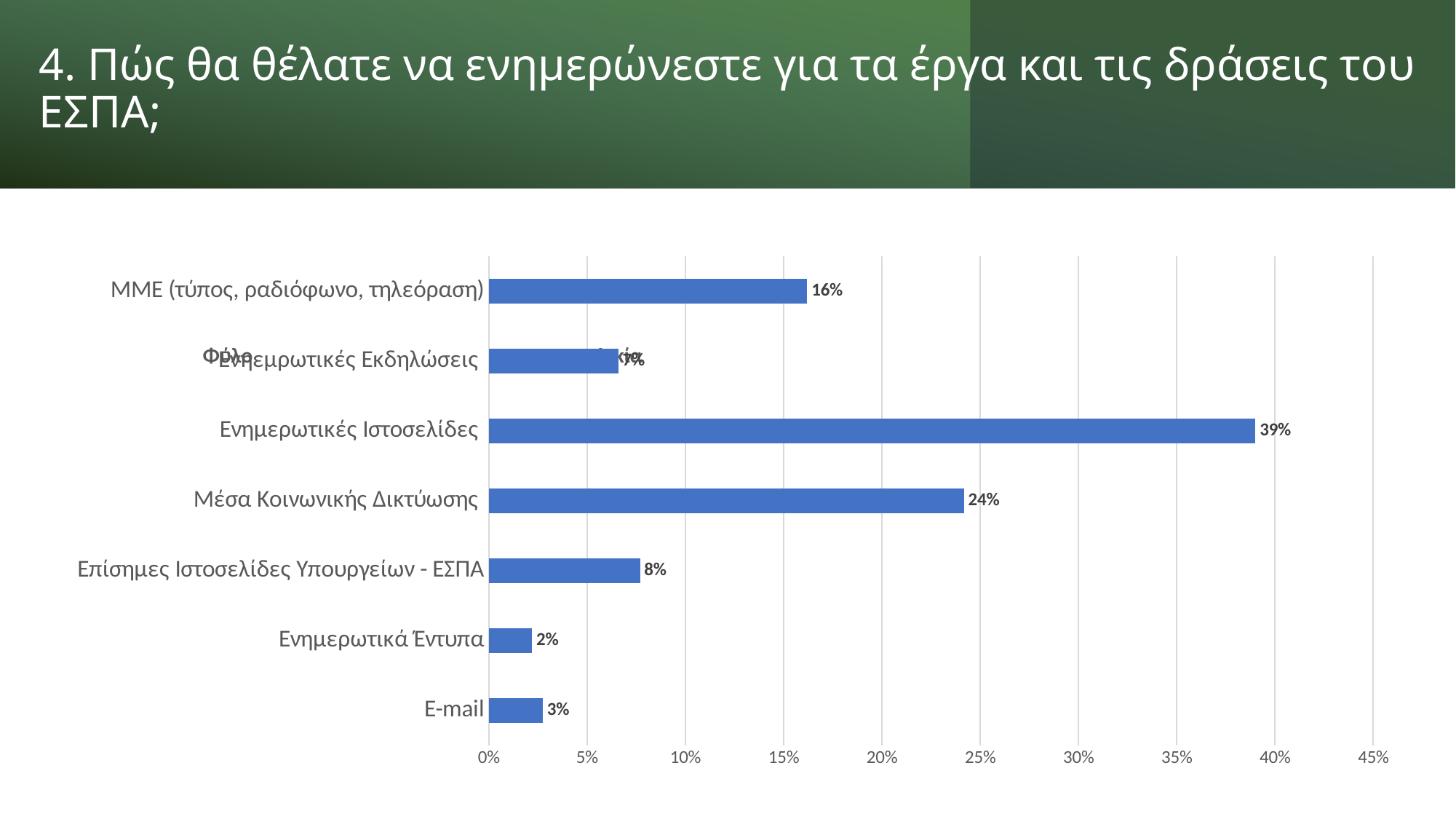
What is the difference between the values for Ενημερωτικές Ιστοσελίδες and Μέσα Κοινωνικής Δικτύωσης? 15% What kind of chart is shown on the slide? bar chart What is the value for Μέσα Κοινωνικής Δικτύωσης? 24% Which is larger, the value for ΜΜΕ (τύπος, ραδιόφωνο, τηλεόραση) or the value for Επίσημες Ιστοσελίδες Υπουργείων - ΕΣΠΑ? ΜΜΕ (τύπος, ραδιόφωνο, τηλεόραση) What is the value for E-mail? 3% Which category has the highest value? Ενημερωτικές Ιστοσελίδες What is the value for Επίσημες Ιστοσελίδες Υπουργείων - ΕΣΠΑ? 8% What is the value for Ενημερωτικά Έντυπα? 2% What is the value for ΜΜΕ (τύπος, ραδιόφωνο, τηλεόραση)? 16% What is the value for Ενημερωτικές Ιστοσελίδες? 39% Is the value for Μέσα Κοινωνικής Δικτύωσης greater or less than 20%? greater Which category has the lowest value? Ενημερωτικά Έντυπα